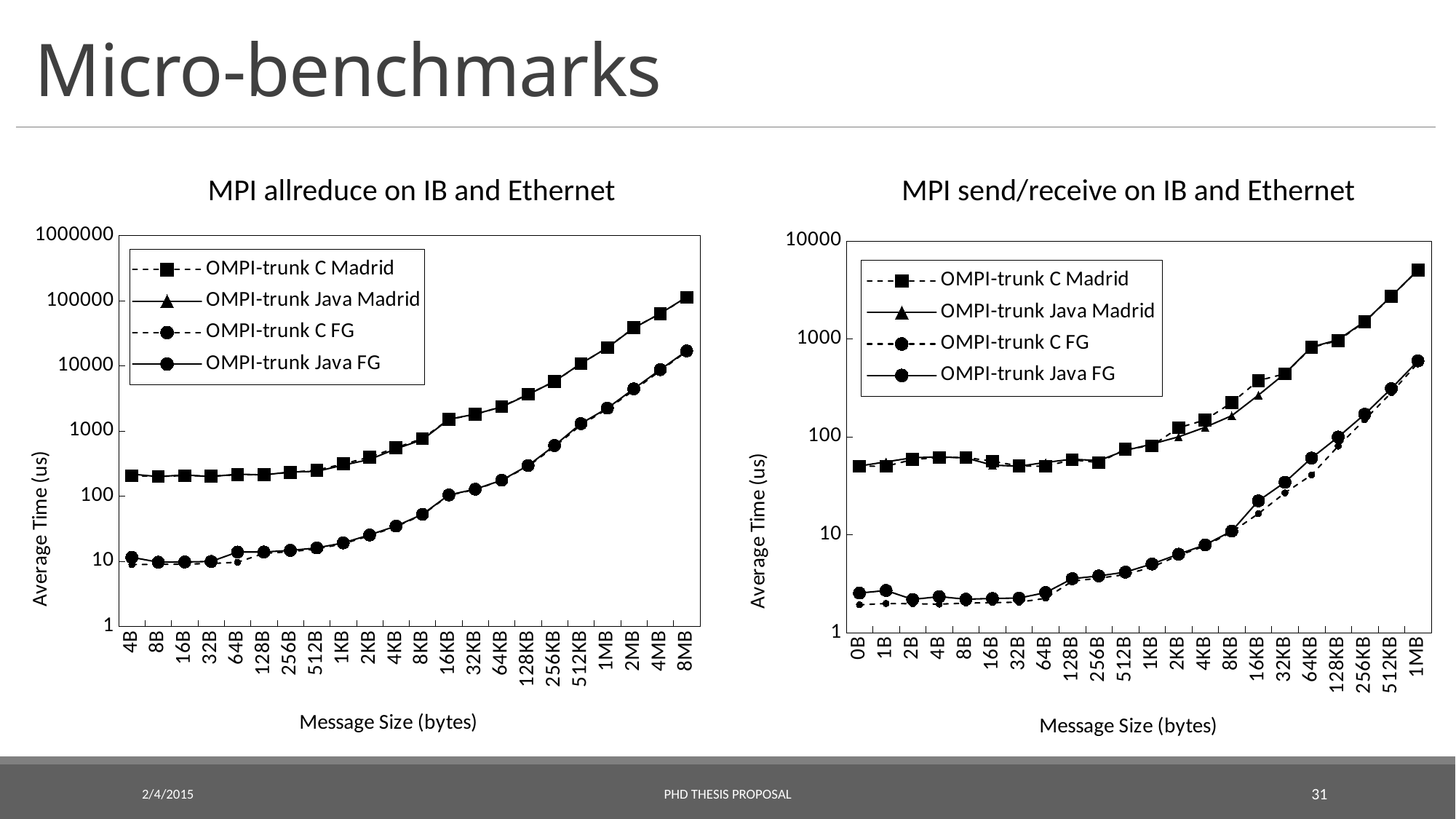
In the 'MPI allreduce on IB and Ethernet' chart, which is larger at 8MB: OMPI-trunk C Madrid or OMPI-trunk Java FG? OMPI-trunk C Madrid How many message sizes are shown on the x axis of the 'MPI allreduce on IB and Ethernet' chart? 22 How many series does the legend of the 'MPI send/receive on IB and Ethernet' chart list? 4 How many message sizes are shown on the x axis of the 'MPI send/receive on IB and Ethernet' chart? 22 In the 'MPI allreduce on IB and Ethernet' chart, do the values for OMPI-trunk C Madrid generally rise or fall as message size increases? rise In the 'MPI allreduce on IB and Ethernet' chart, is the value for OMPI-trunk C Madrid at 4B greater or less than 100? greater In the 'MPI send/receive on IB and Ethernet' chart, at which message size does OMPI-trunk C Madrid reach its highest value? 1MB In the 'MPI send/receive on IB and Ethernet' chart, is the value for OMPI-trunk C Madrid at 0B greater or less than 100? less What kind of chart is the 'MPI allreduce on IB and Ethernet' chart? line chart In the 'MPI allreduce on IB and Ethernet' chart, is the value for OMPI-trunk Java FG at 8MB greater or less than 10000? greater What is the y-axis label of the 'MPI send/receive on IB and Ethernet' chart? Average Time (us)